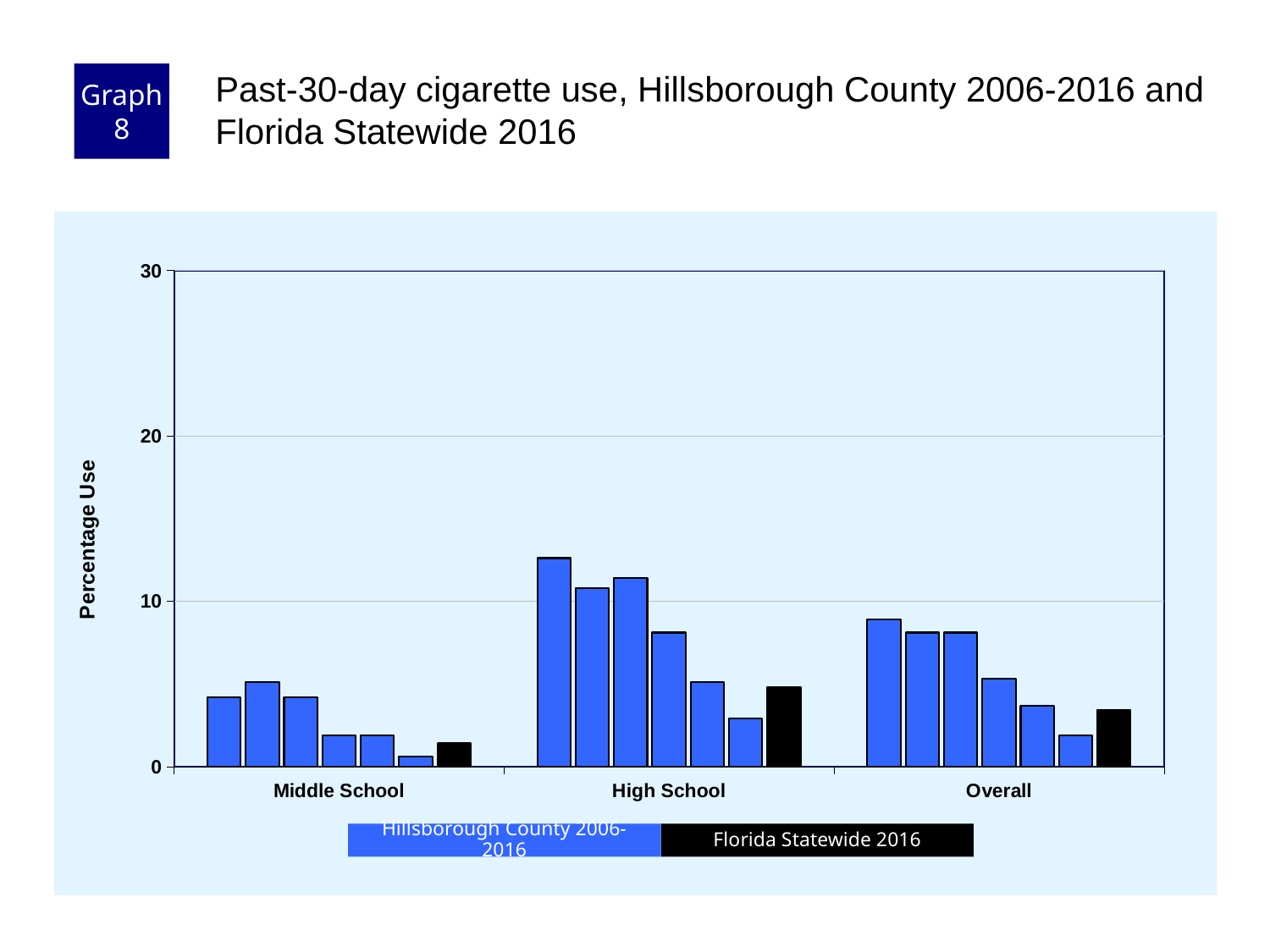
Do the Hillsborough County bars in the Overall group generally rise or fall from left to right? Fall Which colour represents Florida Statewide 2016 in the legend? Black What kind of chart is shown on the slide? Bar chart How many categories are shown on the x axis? 3 Is the tallest bar in the Middle School group greater or less than 10? less Is the tallest bar in the High School group greater or less than 10? greater Which is larger, the Florida Statewide 2016 value for High School or for Middle School? High School What is the label on the y axis? Percentage Use Which category group has the highest bar overall? High School How many series does the legend list? 2 Is the tallest bar in the Overall group greater or less than 10? less